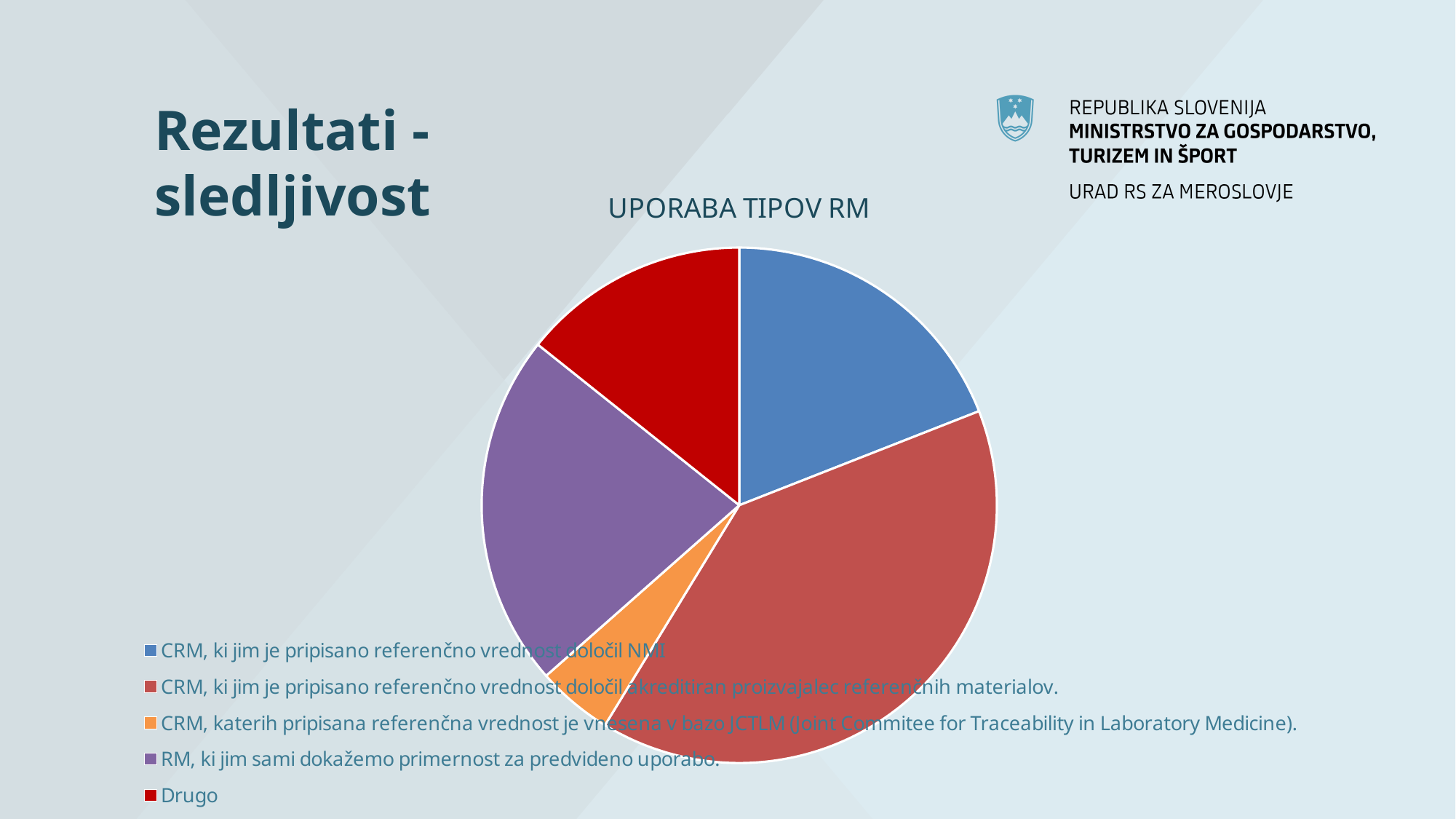
How many slices does the pie chart have? 5 What is the title of the chart? UPORABA TIPOV RM Which slice is larger: 'CRM, ki jim je pripisano referenčno vrednost določil NMI' or 'CRM, ki jim je pripisano referenčno vrednost določil akreditiran proizvajalec referenčnih materialov.'? CRM, ki jim je pripisano referenčno vrednost določil akreditiran proizvajalec referenčnih materialov. What colour is the slice for 'Drugo'? dark red Which category has the largest slice of the pie? CRM, ki jim je pripisano referenčno vrednost določil akreditiran proizvajalec referenčnih materialov. What kind of chart is shown on the slide? pie chart How many entries does the legend list? 5 Which slice is larger: 'Drugo' or 'CRM, katerih pripisana referenčna vrednost je vnesena v bazo JCTLM'? Drugo Which slice is larger: 'CRM, ki jim je pripisano referenčno vrednost določil akreditiran proizvajalec referenčnih materialov.' or 'RM, ki jim sami dokažemo primernost za predvideno uporabo.'? CRM, ki jim je pripisano referenčno vrednost določil akreditiran proizvajalec referenčnih materialov. Which category has the smallest slice of the pie? CRM, katerih pripisana referenčna vrednost je vnesena v bazo JCTLM (Joint Commitee for Traceability in Laboratory Medicine).